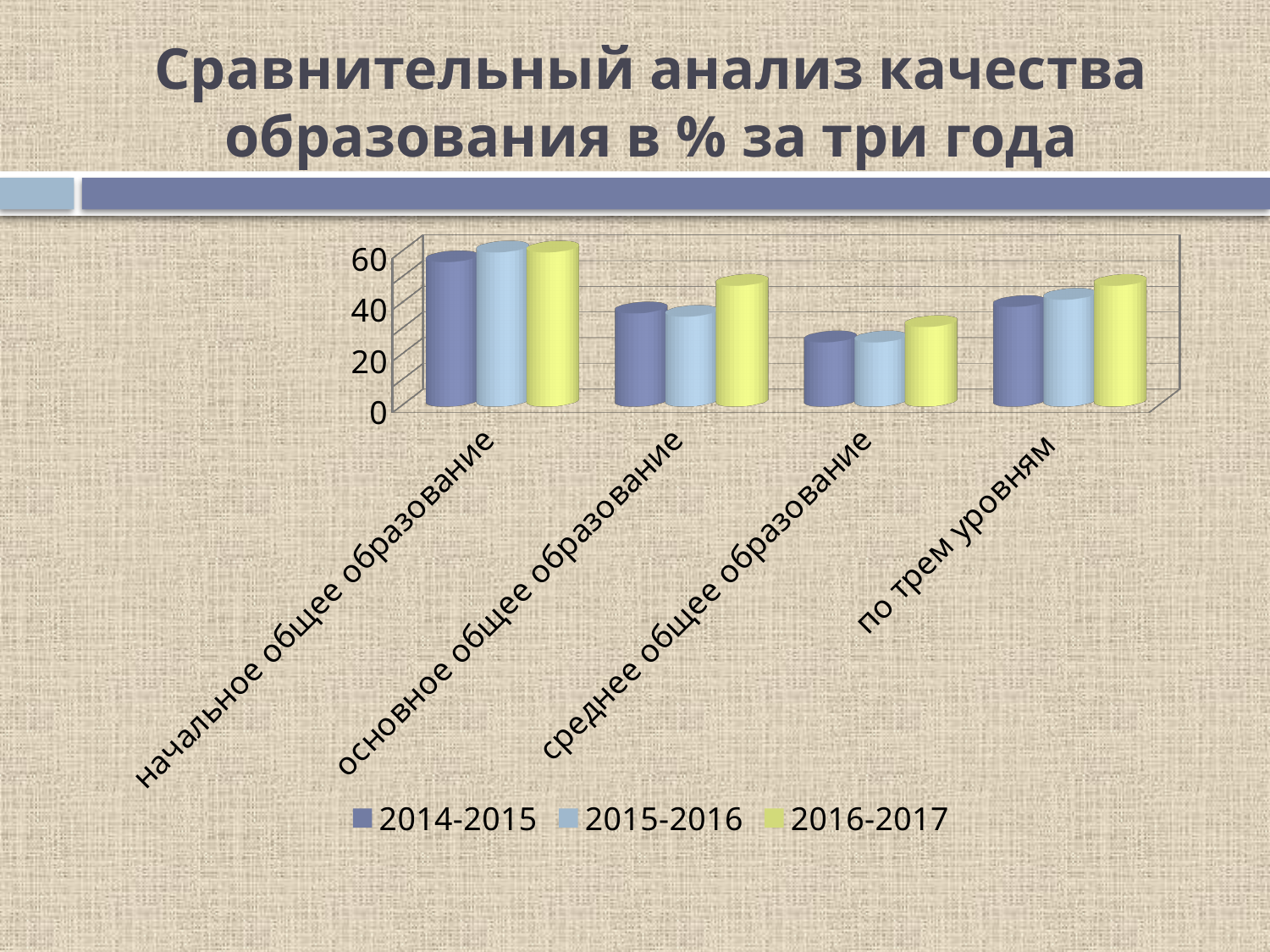
Is the value for среднее общее образование in 2016-2017 greater or less than 40? less For основное общее образование, which series has the larger value: 2014-2015 or 2016-2017? 2016-2017 Which category has the highest values across all three series? начальное общее образование Is the value for основное общее образование in 2016-2017 greater or less than 40? greater What kind of chart is shown on the slide? bar chart Which category has the lowest values across all three series? среднее общее образование In the 2016-2017 series, which is larger: начальное общее образование or среднее общее образование? начальное общее образование How many series does the chart's legend list? 3 What is the title of the slide containing the chart? Сравнительный анализ качества образования в % за три года How many categories are shown on the x axis of the chart? 4 Is the value for начальное общее образование in 2014-2015 greater or less than 40? greater What are the series names listed in the chart's legend? 2014-2015, 2015-2016, 2016-2017